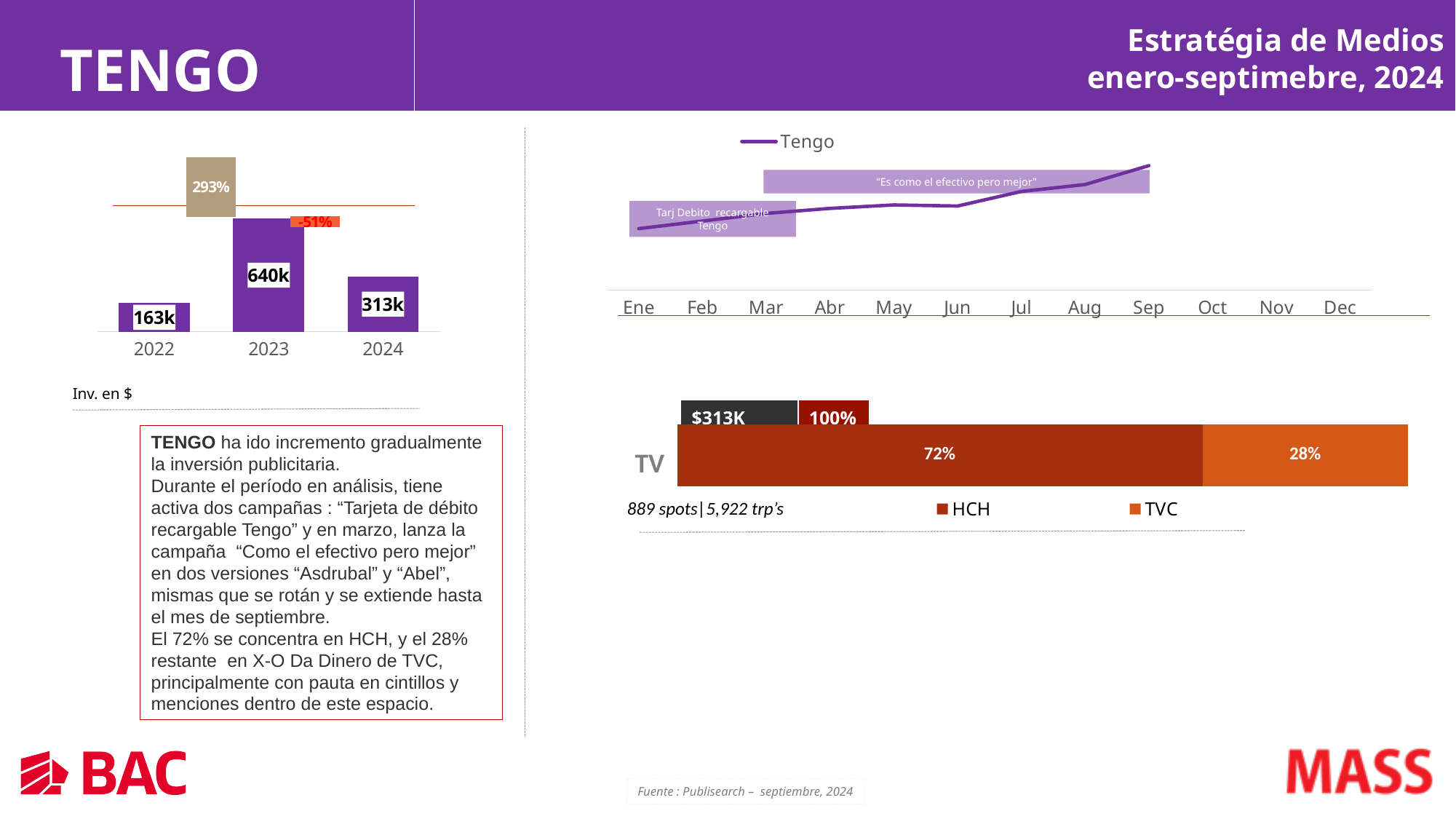
In the bar chart on the left (Inv. en $), what is the value for 2022? 163k In the TV stacked bar chart on the right, which is larger, HCH or TVC? HCH In the bar chart on the left (Inv. en $), what is the value for 2023? 640k In the TV stacked bar chart on the right, what share does TVC have? 28% In the bar chart on the left (Inv. en $), which year has the highest value? 2023 In the bar chart on the left (Inv. en $), what percentage change is labelled between 2022 and 2023? 293% In the bar chart on the left (Inv. en $), what percentage change is labelled between 2023 and 2024? -51% In the bar chart on the left (Inv. en $), how many years are shown? 3 In the bar chart on the left (Inv. en $), what is the value for 2024? 313k In the TV stacked bar chart on the right, what share does HCH have? 72% In the line chart at the top right, what series name does the legend show? Tengo In the bar chart on the left (Inv. en $), which year has the lowest value? 2022